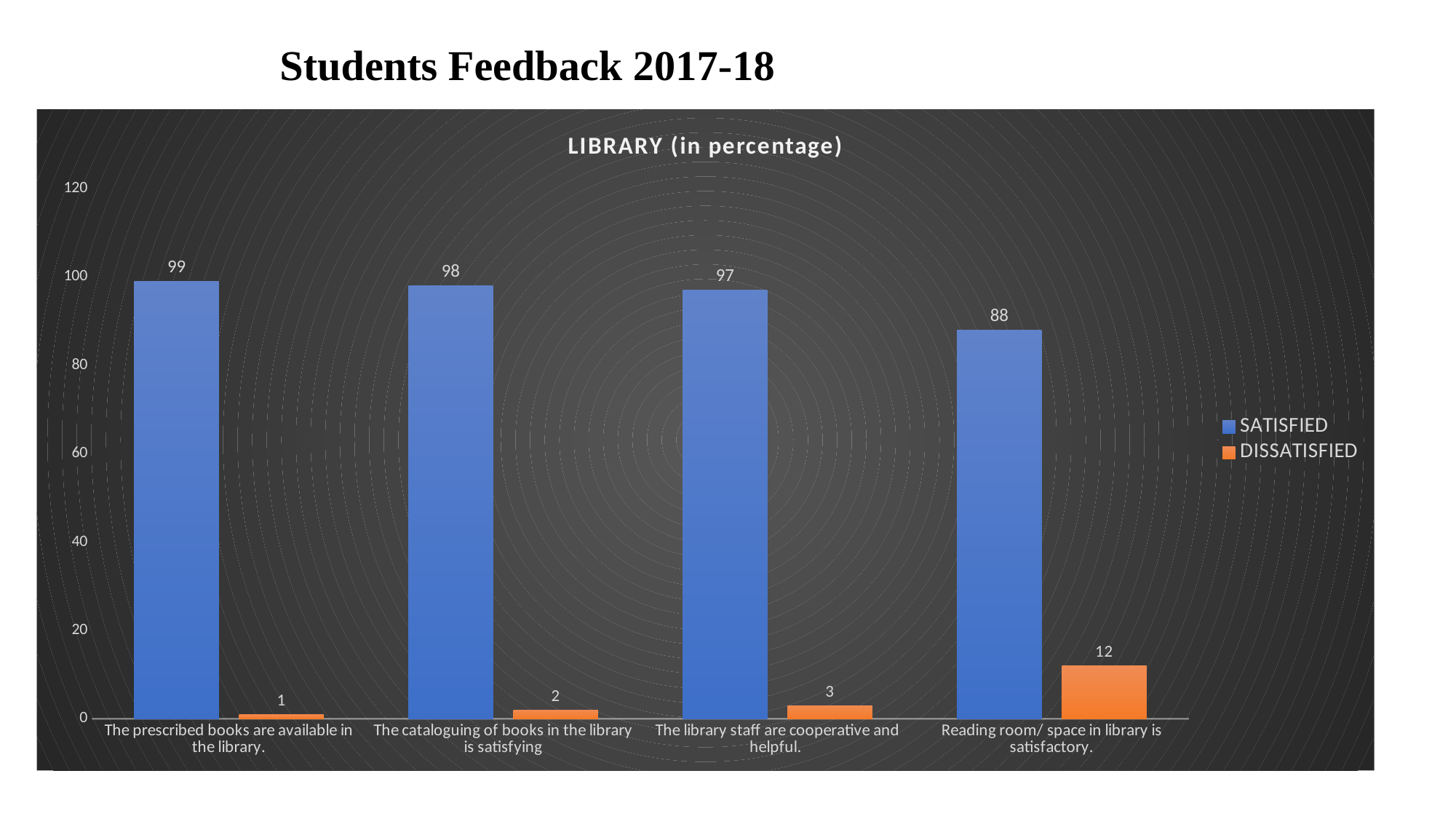
What is the DISSATISFIED value for "The cataloguing of books in the library is satisfying"? 2 What kind of chart is shown on the slide? Bar chart What is the DISSATISFIED value for "Reading room/ space in library is satisfactory."? 12 What is the difference between the SATISFIED values for "The prescribed books are available in the library." and "Reading room/ space in library is satisfactory."? 11 Which is larger: the DISSATISFIED value for "The library staff are cooperative and helpful." or for "The prescribed books are available in the library."? The library staff are cooperative and helpful. How many categories are shown on the x axis? 4 What is the title of the chart? LIBRARY (in percentage) Which category has the lowest SATISFIED value? Reading room/ space in library is satisfactory. What is the SATISFIED value for "The prescribed books are available in the library."? 99 How many series does the legend list? 2 What is the SATISFIED value for "The library staff are cooperative and helpful."? 97 Which category has the highest DISSATISFIED value? Reading room/ space in library is satisfactory.